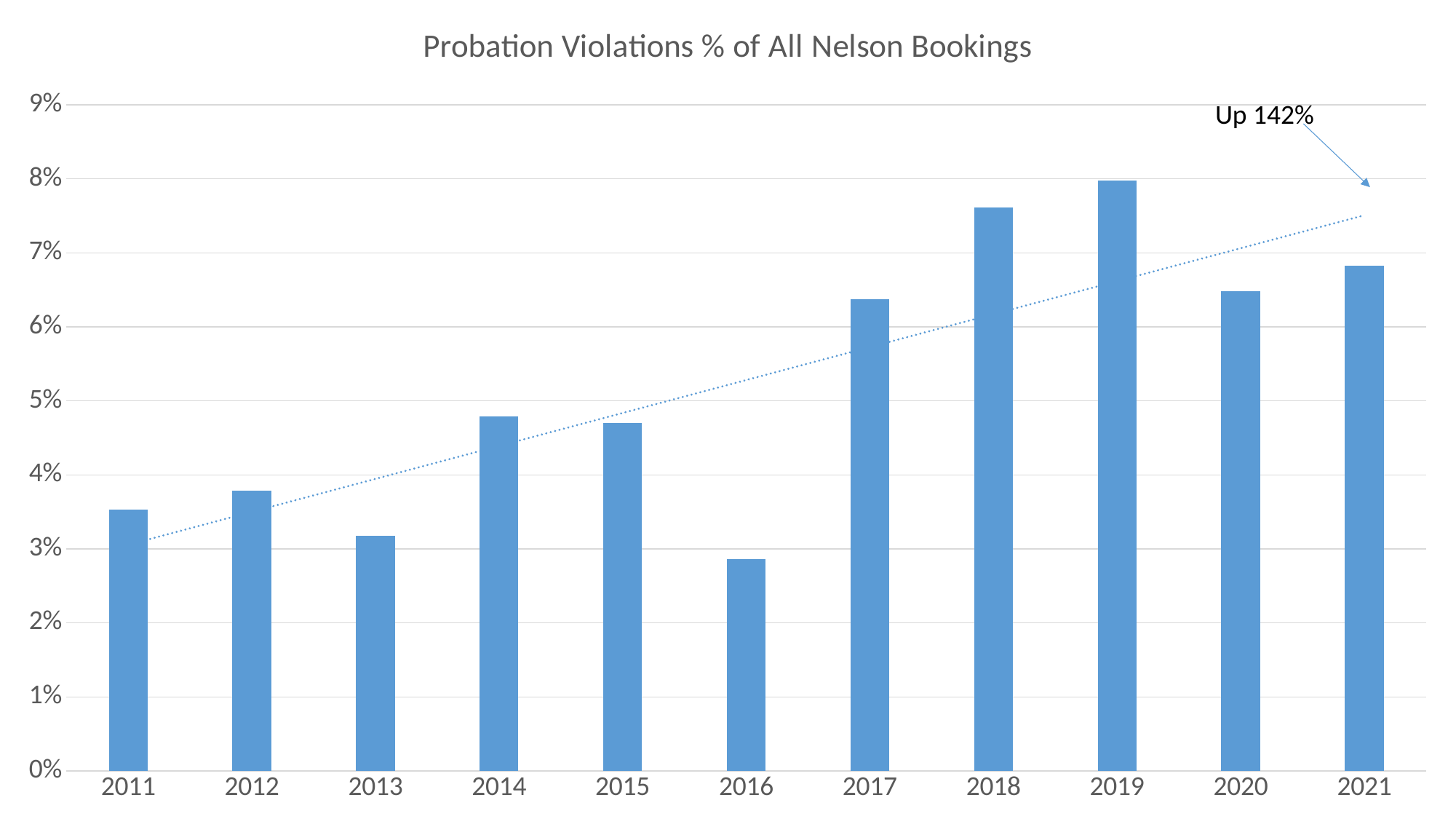
Which year has a higher value, 2012 or 2013? 2012 Is the value for 2021 greater or less than 7%? less Is the value for 2016 greater or less than 3%? less What does the annotation text near the top right of the chart say? Up 142% Which year has the highest probation violations percentage? 2019 What kind of chart is shown on the slide? bar chart How many years are shown on the x axis of the chart? 11 Is the value for 2018 greater or less than 7%? greater Overall, do the values rise or fall from 2011 to 2021? rise Which year has the lowest probation violations percentage? 2016 What is the title of the chart? Probation Violations % of All Nelson Bookings